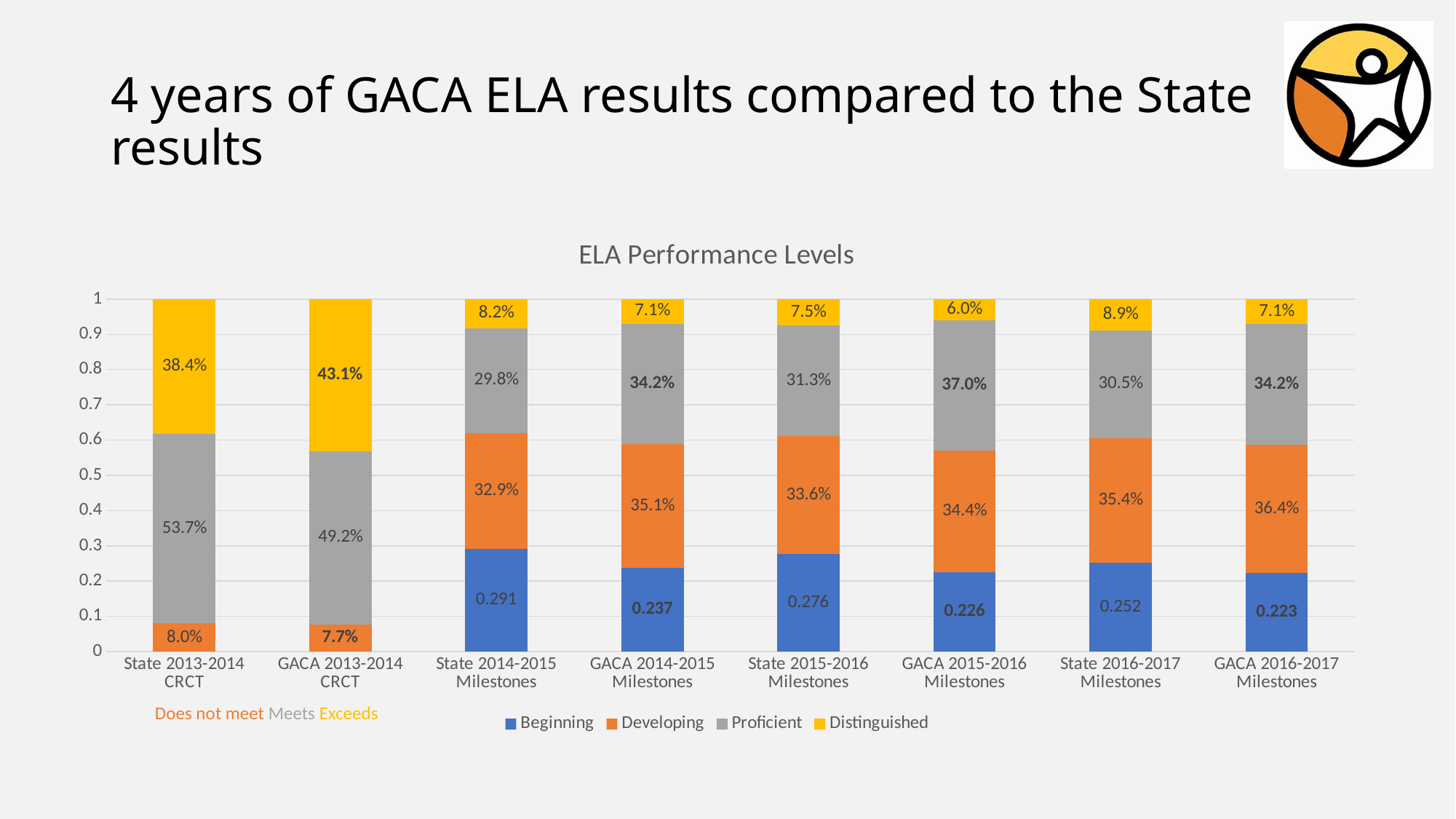
What is the difference between the Proficient values for GACA 2014-2015 Milestones and State 2014-2015 Milestones? 4.4% What is the Exceeds (yellow) value for GACA 2013-2014 CRCT? 43.1% Among the Milestones bars, which category has the highest Distinguished value? State 2016-2017 Milestones What is the Beginning value for GACA 2016-2017 Milestones? 0.223 Which has the larger Developing value, State 2015-2016 Milestones or GACA 2015-2016 Milestones? GACA 2015-2016 Milestones What is the Distinguished value for State 2014-2015 Milestones? 8.2% How many categories are shown on the x axis? 8 Does the Beginning value for GACA rise or fall across the three Milestones years? Fall What kind of chart is shown? Stacked bar chart How many series does the legend list? 4 Which category has the lowest Beginning value? GACA 2016-2017 Milestones What is the Proficient value for GACA 2015-2016 Milestones? 37.0%